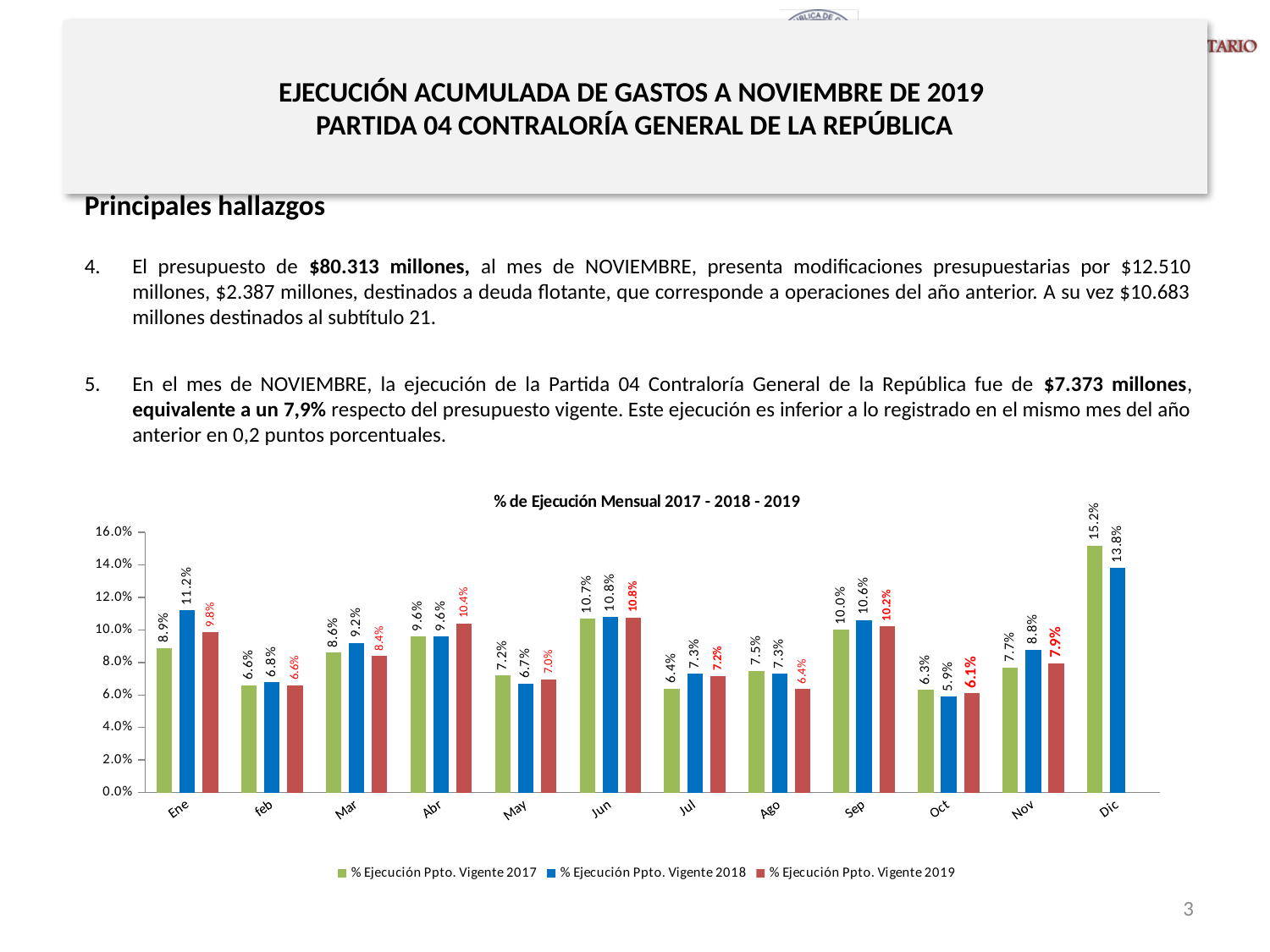
Which month has the lowest value in the % Ejecución Ppto. Vigente 2018 series? Oct Which is larger for Ago: the % Ejecución Ppto. Vigente 2017 value or the % Ejecución Ppto. Vigente 2019 value? % Ejecución Ppto. Vigente 2017 How many series does the legend list? 3 What is the value for Nov in the % Ejecución Ppto. Vigente 2019 series? 7.9% Is the value for Dic in the % Ejecución Ppto. Vigente 2018 series greater or less than 12.0%? greater What is the difference between the 2018 and 2019 values for Ene? 1.4% What is the value for Ene in the % Ejecución Ppto. Vigente 2018 series? 11.2% What is the value for Dic in the % Ejecución Ppto. Vigente 2017 series? 15.2% What is the title of the chart? % de Ejecución Mensual 2017 - 2018 - 2019 Which month has the highest value in the % Ejecución Ppto. Vigente 2019 series? Jun What kind of chart is shown on the slide? Bar chart How many months are shown on the x axis of the chart? 12